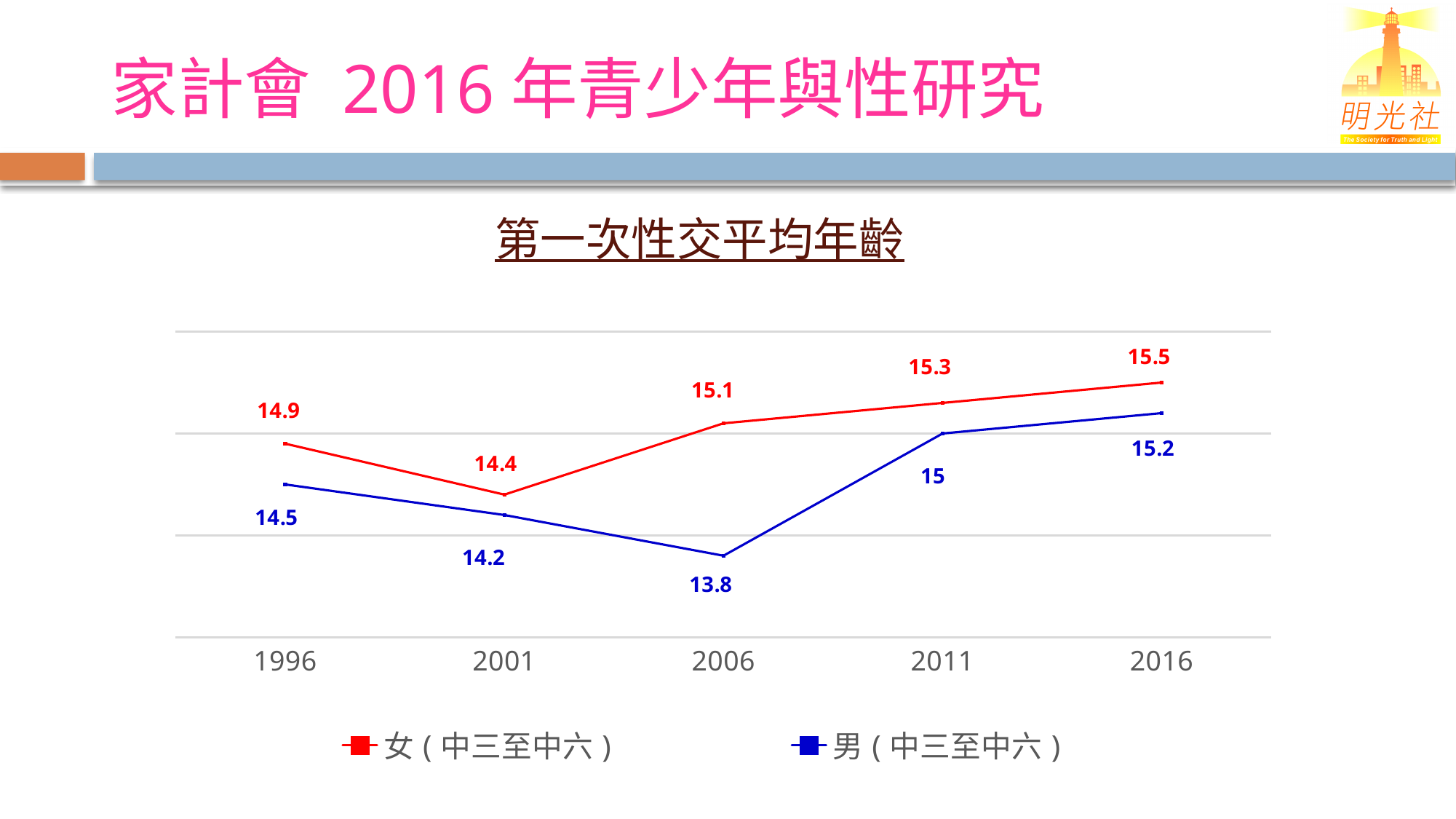
How many years are shown on the x axis? 5 In which year is the value for 女 (中三至中六) highest? 2016 What is the value for 男 (中三至中六) in 2006? 13.8 What is the difference between the 女 (中三至中六) and 男 (中三至中六) values in 2006? 1.3 What is the value for 女 (中三至中六) in 2016? 15.5 What is the value for 女 (中三至中六) in 2001? 14.4 Does the value for 女 (中三至中六) rise or fall from 2001 to 2016? Rise In which year is the value for 男 (中三至中六) lowest? 2006 What is the value for 男 (中三至中六) in 2011? 15 How many series does the legend list? 2 Which series has the larger value in 1996, 女 (中三至中六) or 男 (中三至中六)? 女 (中三至中六) What kind of chart is shown on the slide? Line chart